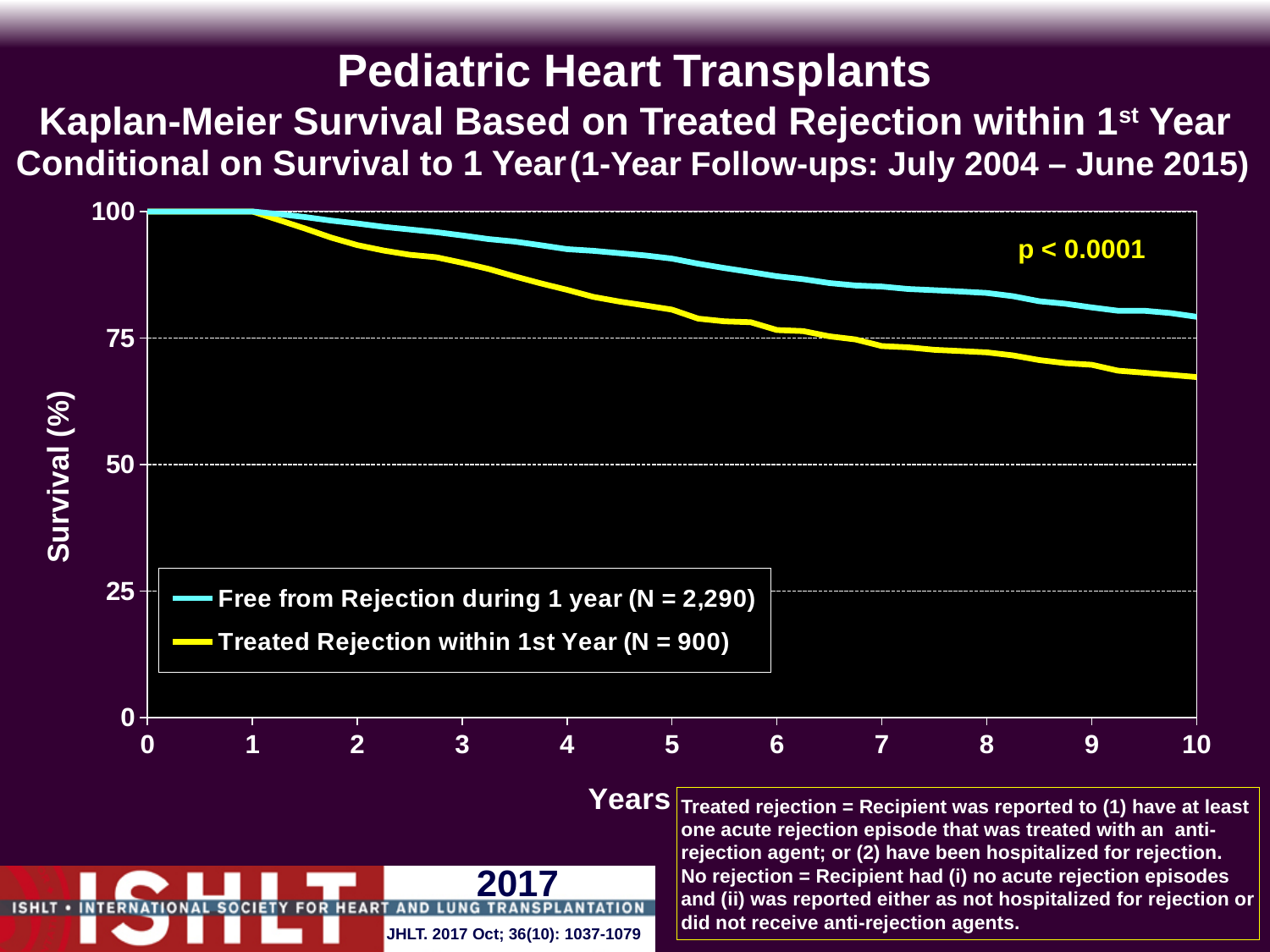
What is the p-value shown on the chart? p < 0.0001 Is the survival value for the Free from Rejection during 1 year series at year 10 greater or less than 100? less At year 10, which series has the higher survival: Free from Rejection during 1 year or Treated Rejection within 1st Year? Free from Rejection during 1 year What is the survival value for the Free from Rejection during 1 year series at year 0? 100 What is the N for the Treated Rejection within 1st Year series? 900 Is the survival value for the Treated Rejection within 1st Year series at year 10 greater or less than 75? less What type of chart is shown on the slide? line chart What is the maximum value shown on the Years axis? 10 Is the survival value for the Treated Rejection within 1st Year series at year 5 greater or less than 75? greater Do the survival values rise or fall as years increase? fall How many series does the legend list? 2